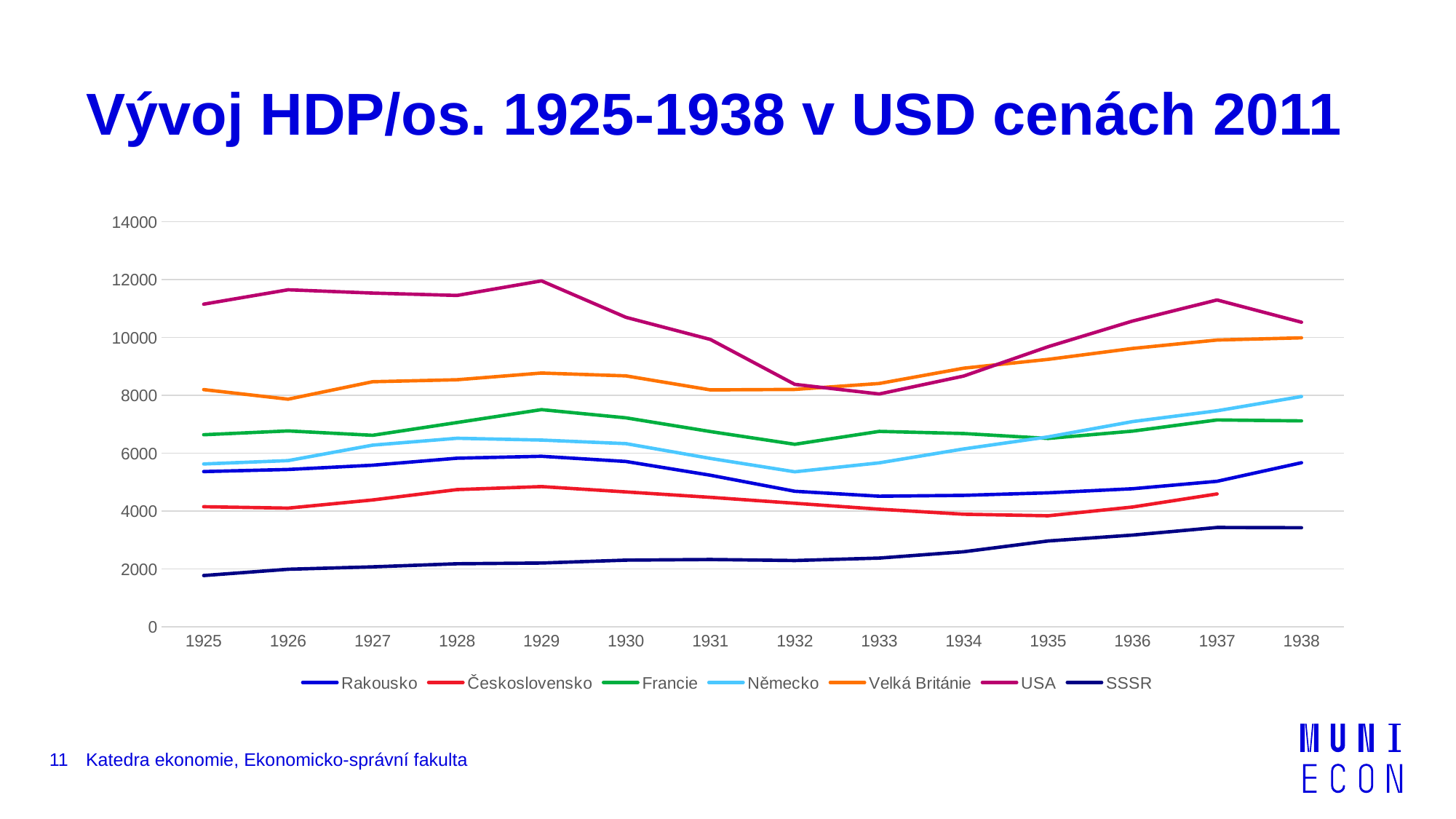
In 1938, which is higher: Velká Británie or USA? USA Is the value for SSSR in 1925 greater or less than 2000? less Is the value for Německo in 1932 greater or less than 6000? less How many series does the legend list? 7 What kind of chart is shown on the slide? line chart How many years are shown on the x axis? 14 Which country has the lowest value in 1938? SSSR In 1938, which is higher: Německo or Francie? Německo Which country has the highest value in 1929? USA Is the value for USA in 1929 greater or less than 10000? greater Does the value for USA rise or fall between 1929 and 1933? fall What is the title of the chart? Vývoj HDP/os. 1925-1938 v USD cenách 2011